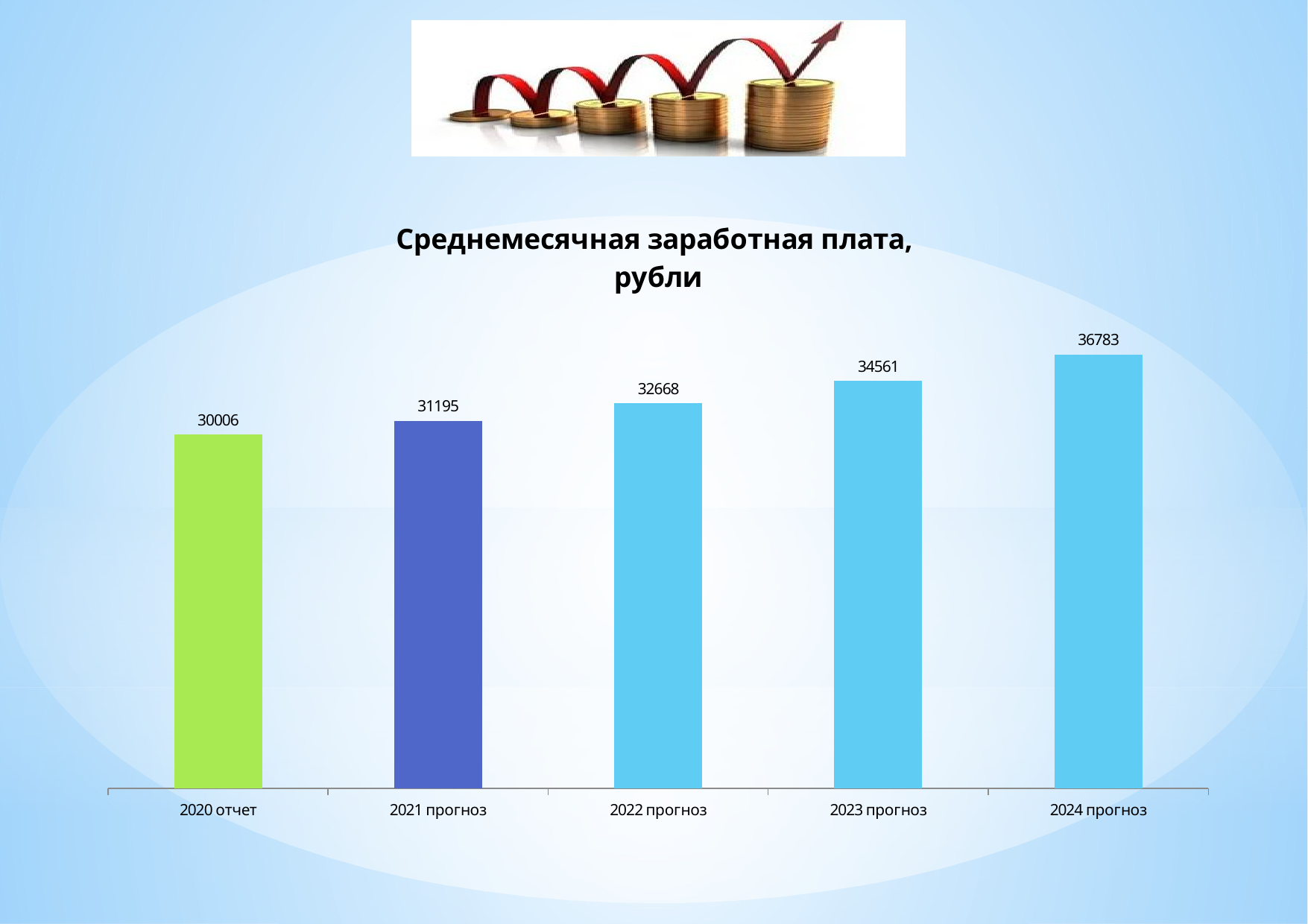
How many categories are shown on the x axis? 5 Do the values rise or fall from 2020 отчет to 2024 прогноз? rise What kind of chart is shown on the slide? bar chart Which category has the lowest value? 2020 отчет What is the difference between the values for 2023 прогноз and 2022 прогноз? 1893 Which is larger, the value for 2021 прогноз or the value for 2023 прогноз? 2023 прогноз Which category has the highest value? 2024 прогноз What is the value for 2024 прогноз? 36783 What is the title of the chart? Среднемесячная заработная плата, рубли What is the difference between the values for 2024 прогноз and 2020 отчет? 6777 What is the value for 2022 прогноз? 32668 What is the value for 2020 отчет? 30006